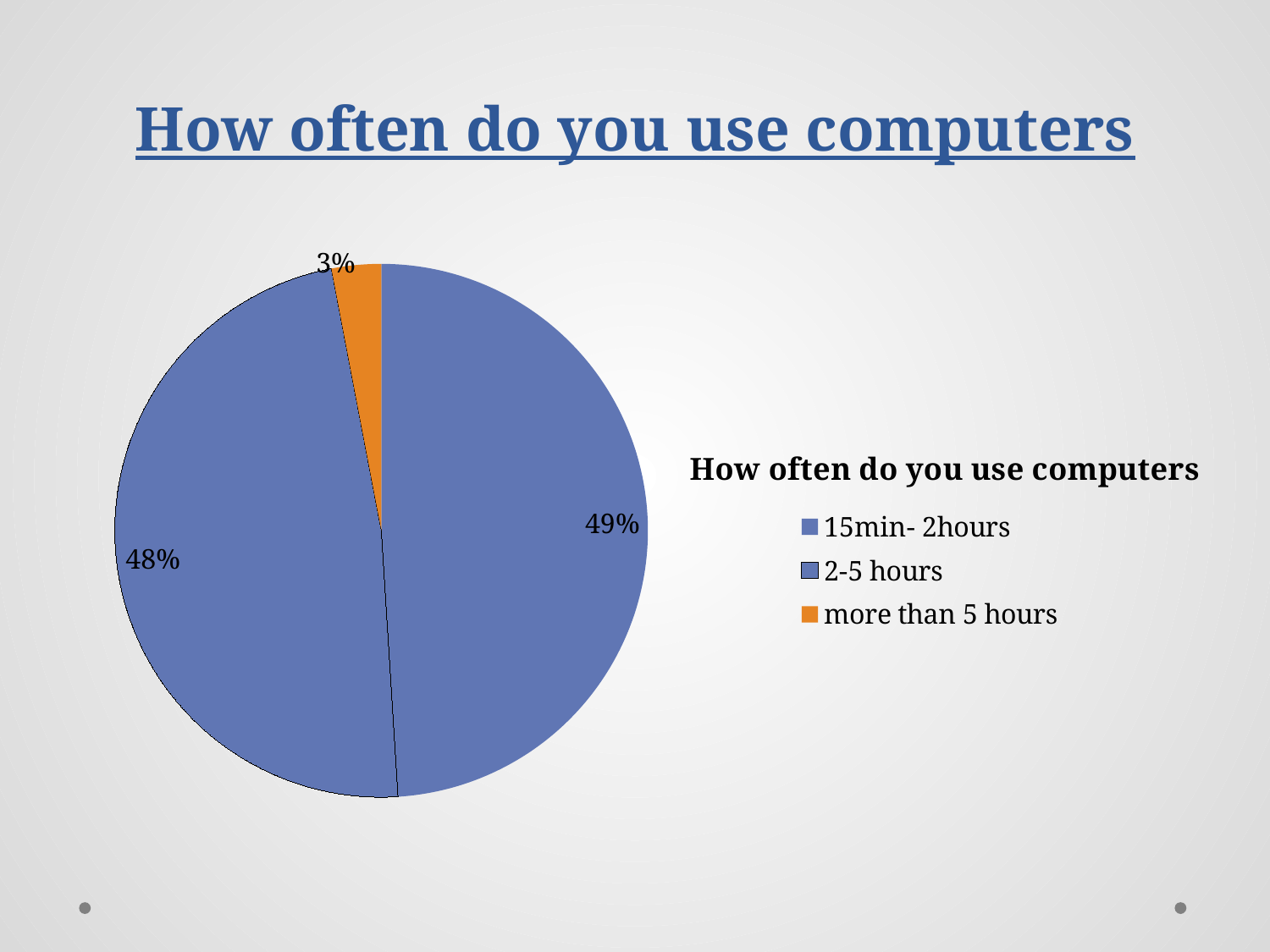
Which is larger, the slice labelled 49% or the slice labelled 3%? 49% Which category has the smallest slice of the pie? more than 5 hours What is the difference between the 49% slice and the 48% slice? 1% What colour is the slice for 'more than 5 hours'? orange How many categories does the legend list? 3 How many slices does the pie chart have? 3 What share of the pie is labelled for 'more than 5 hours'? 3% What kind of chart is shown on the slide? pie chart Is the share for 'more than 5 hours' greater or less than 10%? less What is the largest percentage label shown on the pie chart? 49% What is the title of the chart? How often do you use computers What is the difference between the 49% slice and the 3% slice? 46%